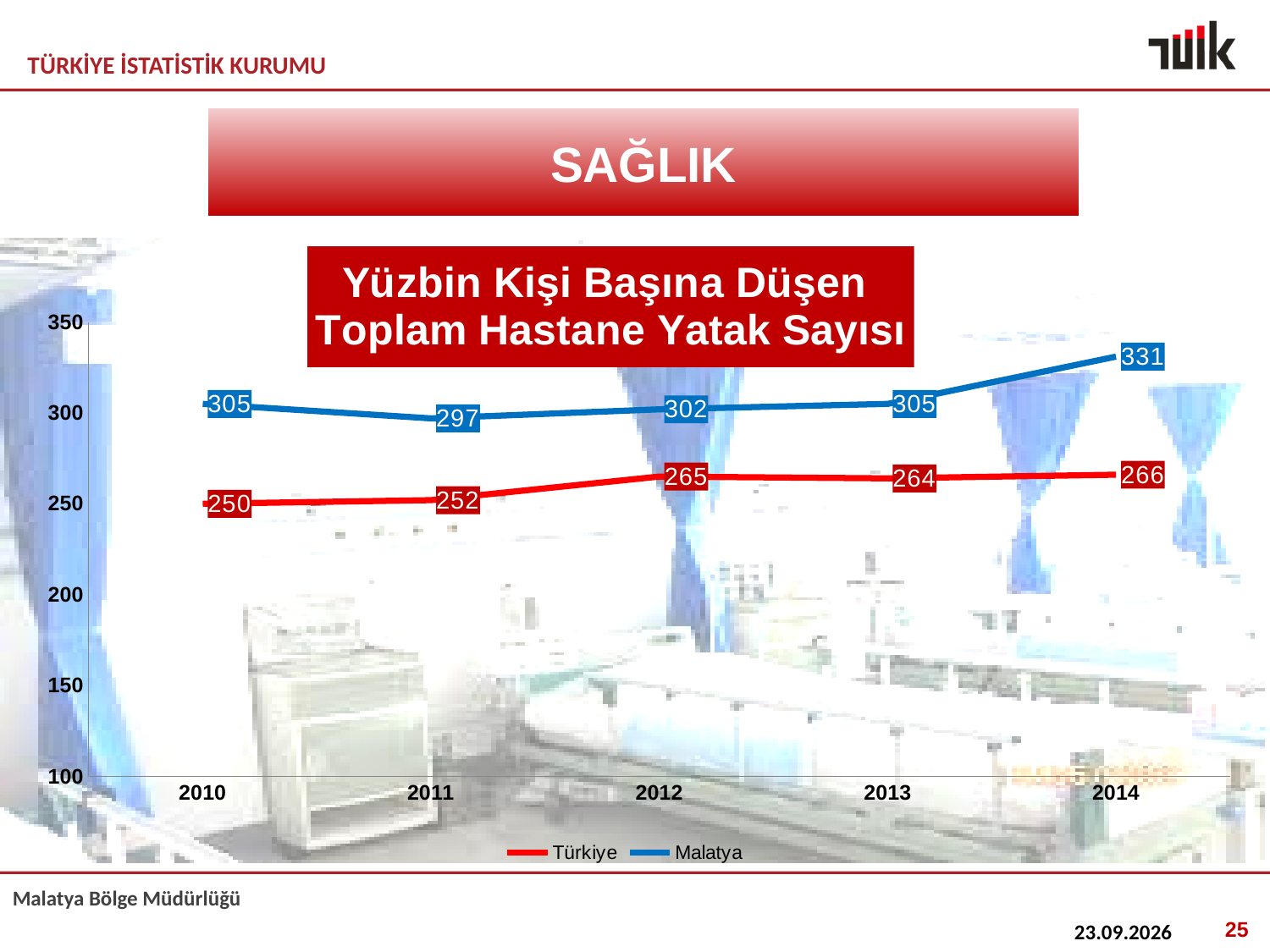
In which year is the Malatya value highest? 2014 How many years are shown on the x axis? 5 What is the value for Malatya in 2011? 297 In which year is the Türkiye value lowest? 2010 What is the difference between the Malatya and Türkiye values in 2014? 65 What is the value for Türkiye in 2010? 250 How many series does the legend list? 2 What is the value for Malatya in 2014? 331 What kind of chart is shown on the slide? Line chart What is the title of the chart? Yüzbin Kişi Başına Düşen Toplam Hastane Yatak Sayısı Which is larger in 2012, the Türkiye value or the Malatya value? Malatya What is the value for Türkiye in 2013? 264